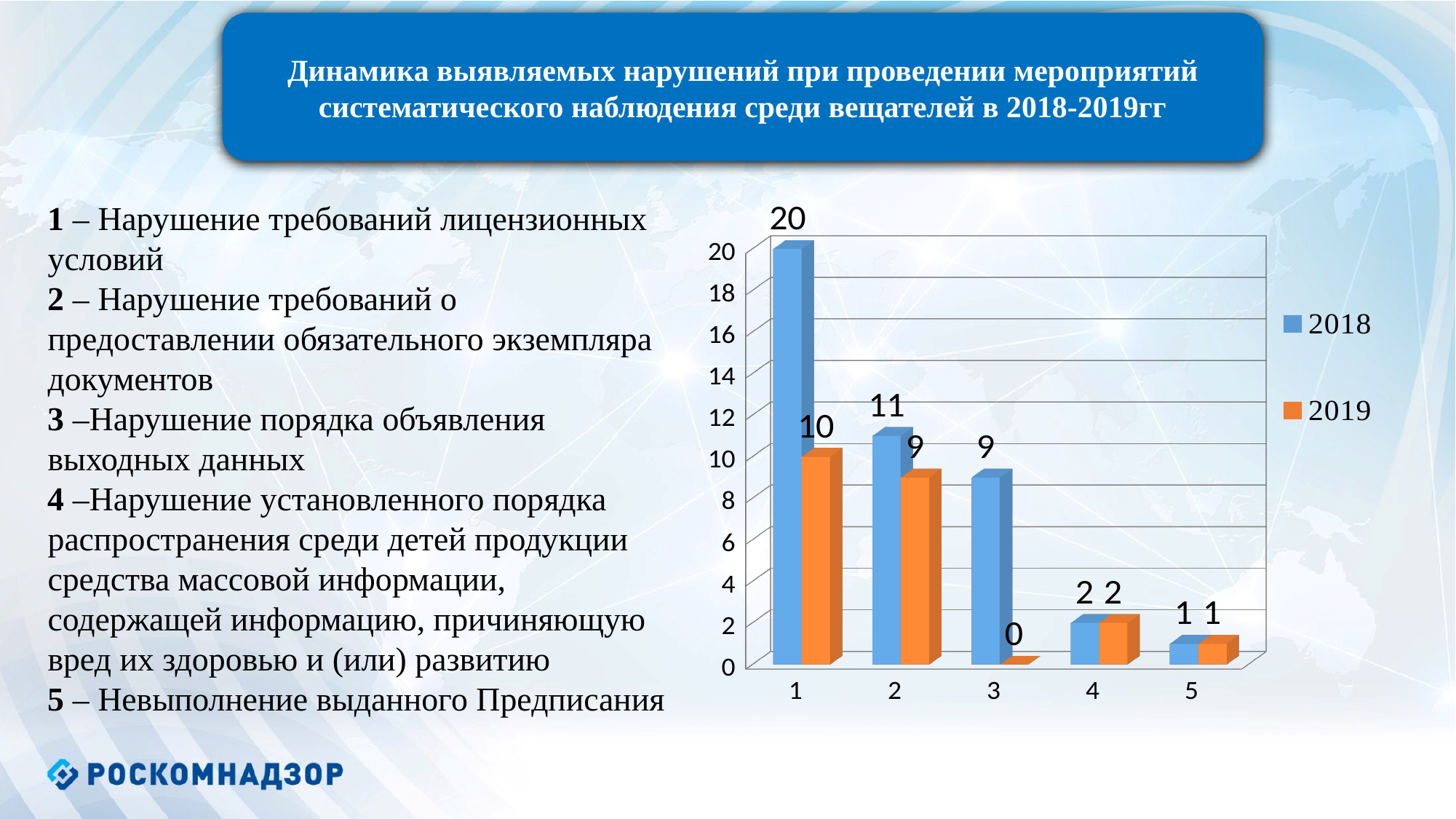
What is the value for category 1 in the 2018 series? 20 What is the value for category 2 in the 2019 series? 9 Which is larger for category 3: the 2018 value or the 2019 value? 2018 Which category has the lowest value in the 2019 series? 3 Which category has the highest value in the 2018 series? 1 What is the difference between the 2018 and 2019 values for category 1? 10 Which colour represents the 2019 series in the legend? orange How many categories are shown on the x axis? 5 How many series does the legend list? 2 What is the value for category 3 in the 2019 series? 0 What kind of chart is shown on the slide? bar chart What is the difference between the 2018 values for category 2 and category 3? 2